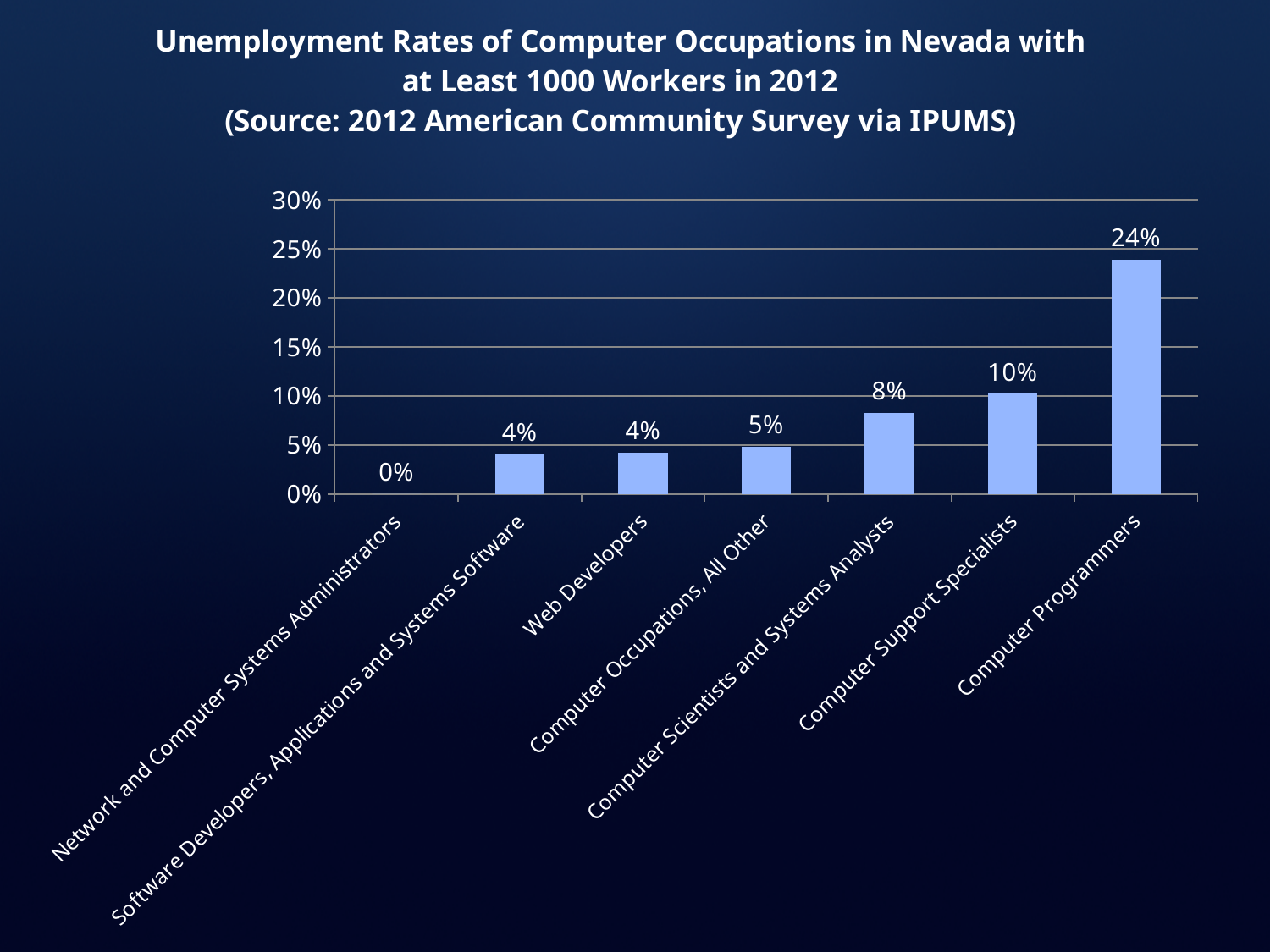
What is the unemployment rate for Computer Programmers? 24% Which occupation has the lowest unemployment rate? Network and Computer Systems Administrators How many occupations are shown in the chart? 7 Which occupation has the highest unemployment rate? Computer Programmers What is the unemployment rate for Network and Computer Systems Administrators? 0% What is the difference in unemployment rate between Computer Programmers and Computer Support Specialists? 14% What is the unemployment rate for Computer Scientists and Systems Analysts? 8% What is the source cited in the chart title? 2012 American Community Survey via IPUMS What is the unemployment rate for Computer Support Specialists? 10% What kind of chart is shown on the slide? bar chart Which has a higher unemployment rate, Computer Occupations, All Other or Computer Scientists and Systems Analysts? Computer Scientists and Systems Analysts Is the unemployment rate for Computer Programmers greater or less than 20%? greater